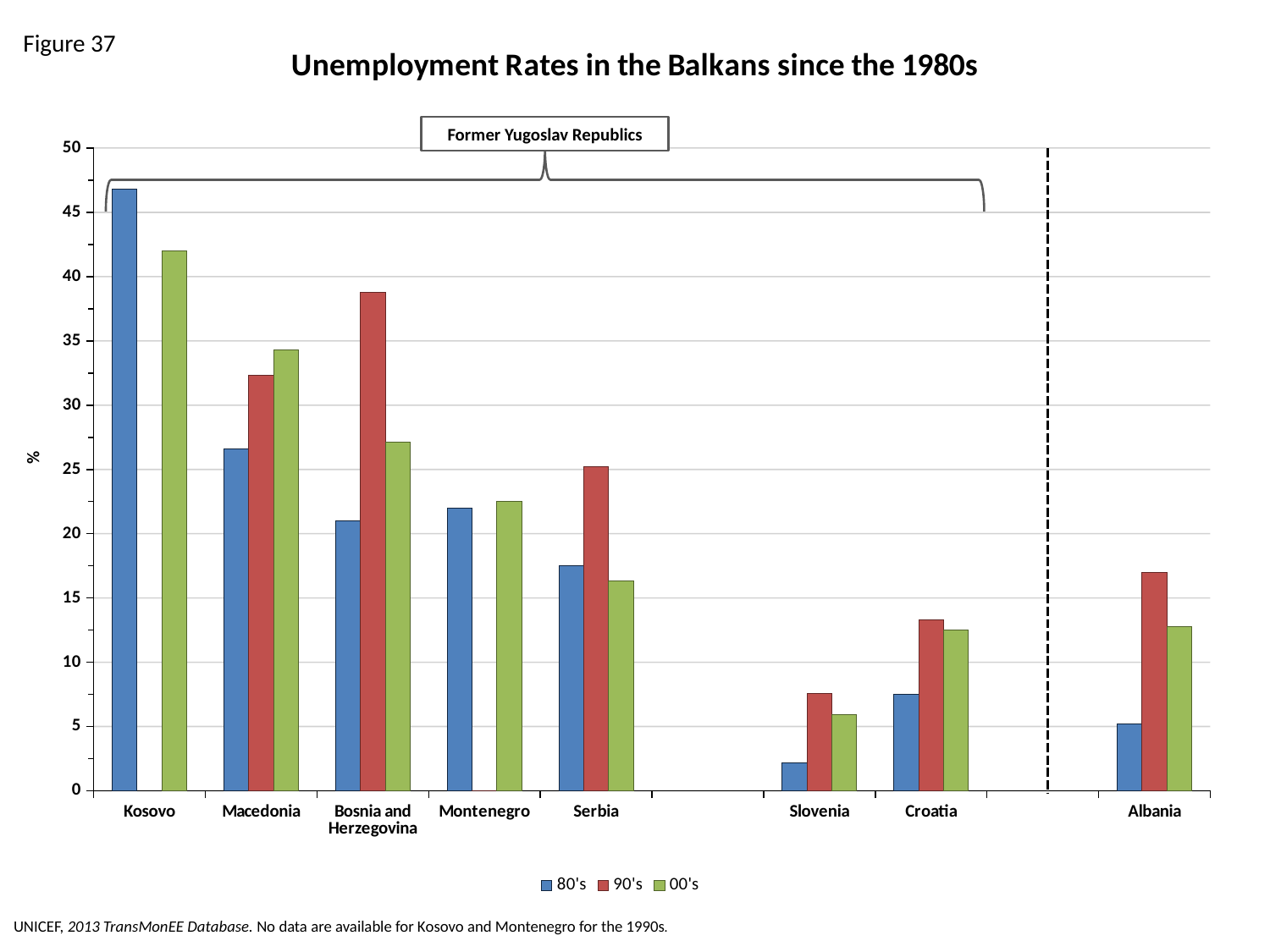
How many series does the legend list? 3 Which country has the highest 80's unemployment rate? Kosovo Is the 80's value for Slovenia greater or less than 5? less Which country has the highest 90's unemployment rate? Bosnia and Herzegovina Is the 80's value for Kosovo greater or less than 40? greater What kind of chart is shown on the slide? bar chart Which country has the lowest 80's unemployment rate? Slovenia How many countries are shown on the x axis? 8 Is the 90's value for Bosnia and Herzegovina greater or less than 35? greater Which country has the lowest 00's unemployment rate? Slovenia Which is larger, the 00's value for Macedonia or the 00's value for Bosnia and Herzegovina? Macedonia What is the title of the chart? Unemployment Rates in the Balkans since the 1980s